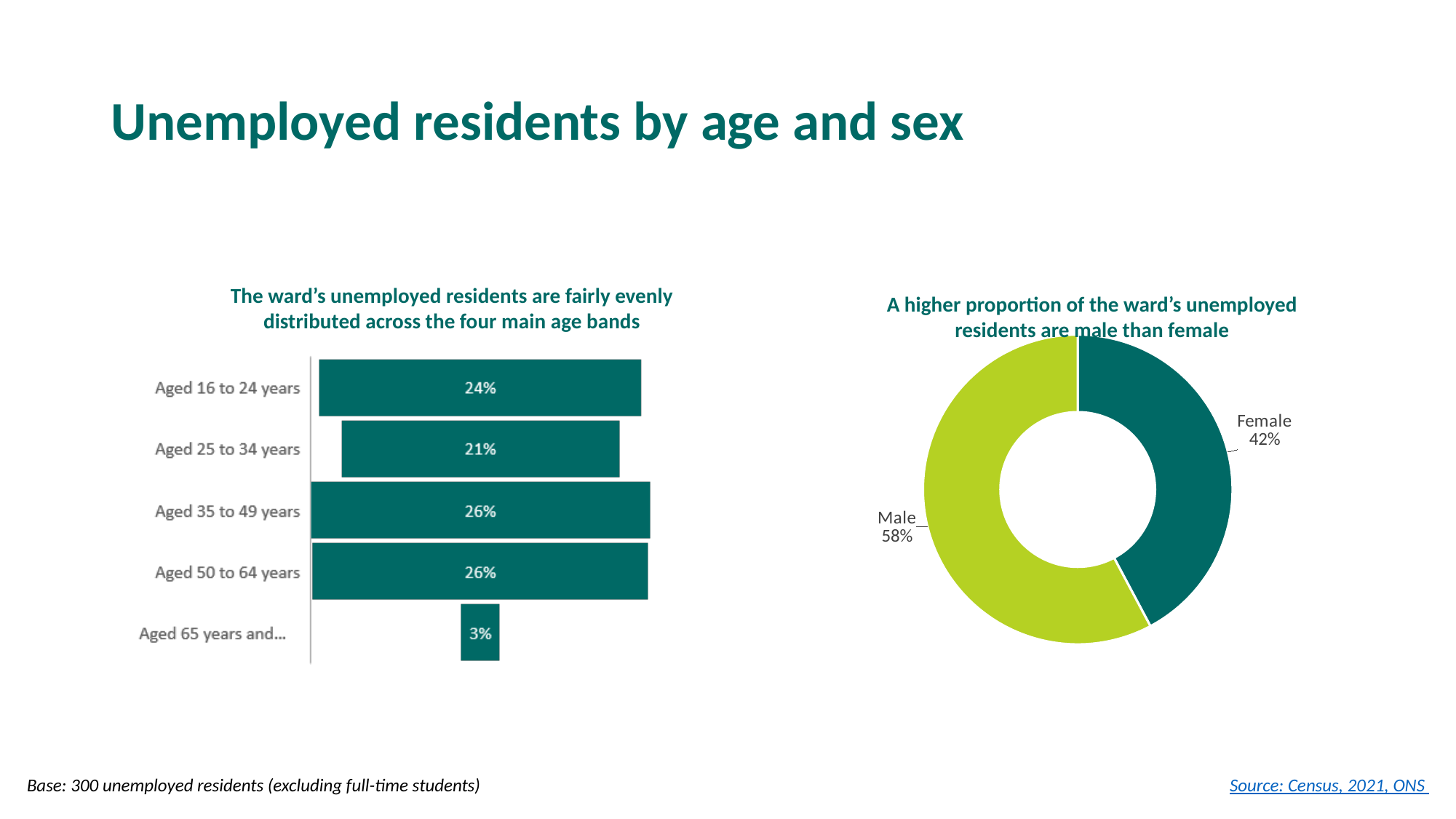
In the doughnut chart on the right, what share of unemployed residents is Female? 42% In the doughnut chart on the right, what is the difference between the Male and Female shares? 16% What is the title of the chart on the right? A higher proportion of the ward's unemployed residents are male than female How many age bands are shown in the bar chart on the left? 5 In the bar chart on the left, which is larger: Aged 35 to 49 years or Aged 25 to 34 years? Aged 35 to 49 years In the bar chart on the left, which age band has the lowest value? Aged 65 years and... In the bar chart on the left, what is the difference between Aged 16 to 24 years and Aged 25 to 34 years? 3% What kind of chart is the chart on the left? Bar chart In the bar chart on the left, what is the value for Aged 16 to 24 years? 24% In the bar chart on the left, what is the value for Aged 50 to 64 years? 26% In the doughnut chart on the right, what share of unemployed residents is Male? 58% In the bar chart on the left, what is the value for Aged 25 to 34 years? 21%